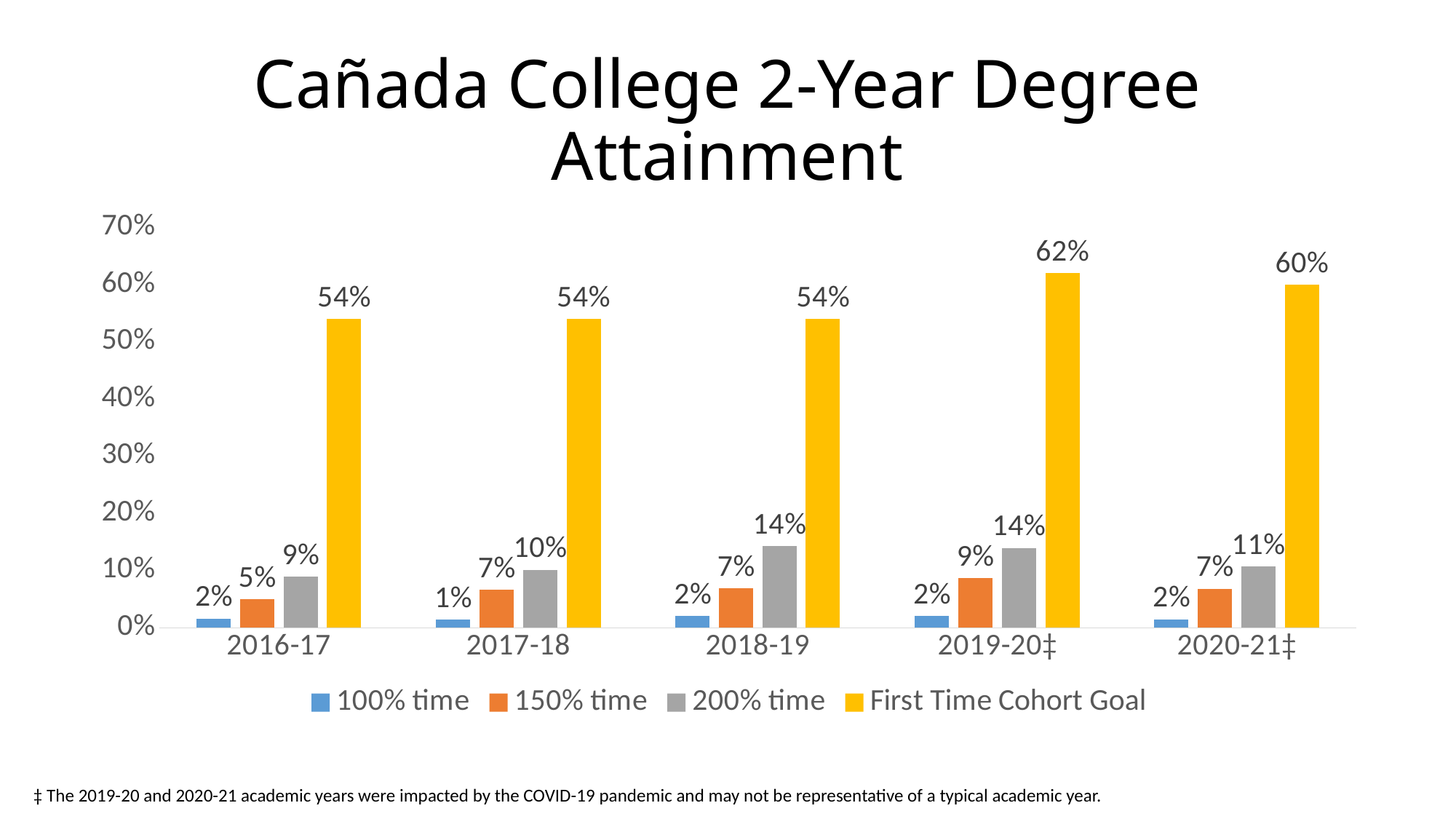
What is the 150% time value for 2017-18? 7% How many academic years are shown on the x axis? 5 Which year has the highest First Time Cohort Goal value? 2019-20‡ What kind of chart is shown on the slide? Bar chart What is the 200% time value for 2018-19? 14% What is the difference between the First Time Cohort Goal and the 200% time value in 2020-21‡? 49% Which colour represents the First Time Cohort Goal series? Yellow Which is larger, the 150% time value for 2019-20‡ or the 150% time value for 2020-21‡? 2019-20‡ Which year has the lowest 200% time value? 2016-17 What is the 100% time value for 2017-18? 1% What is the First Time Cohort Goal value for 2019-20‡? 62% How many series does the legend list? 4